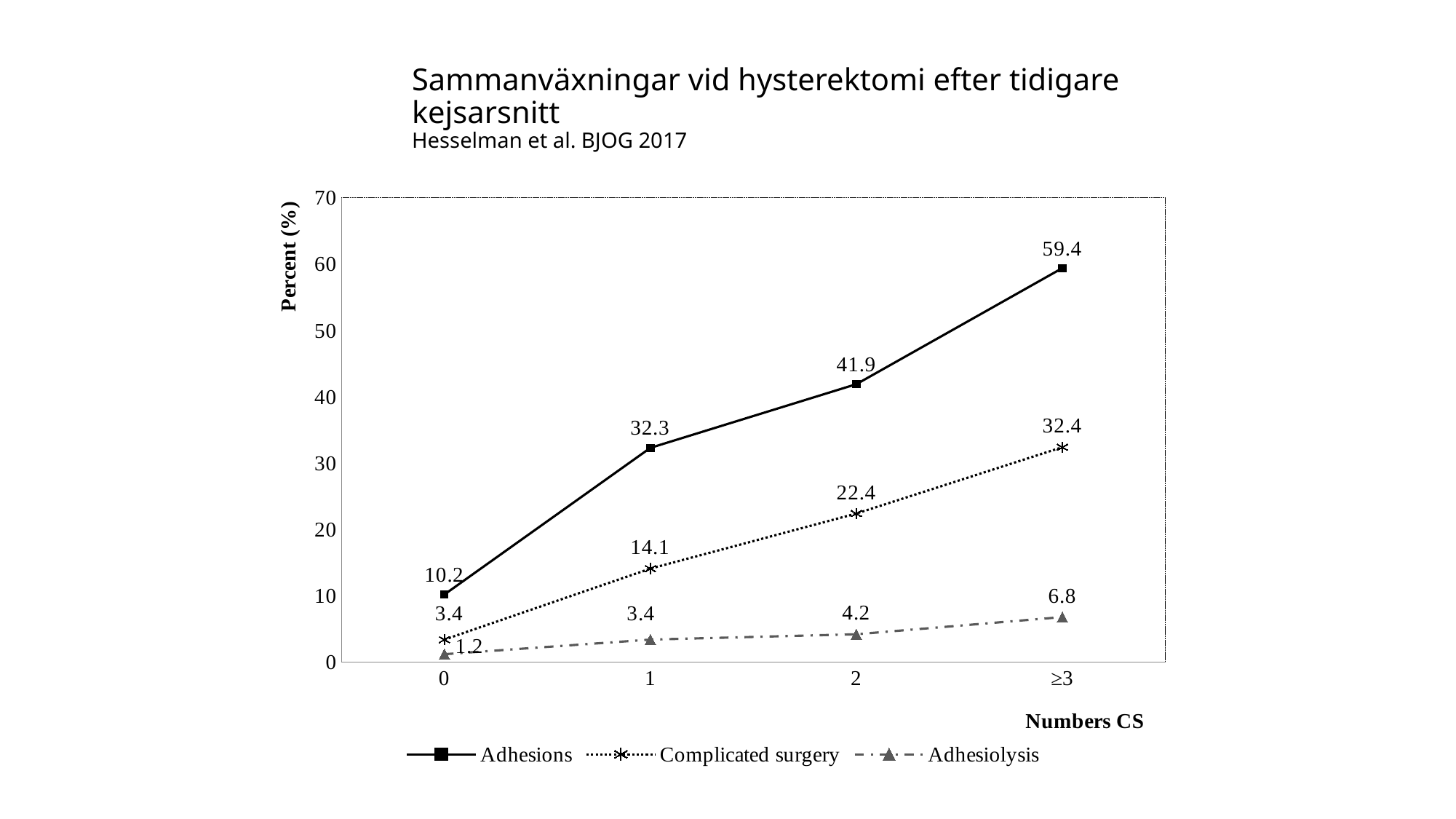
Which is larger at 2 previous CS: Adhesions or Complicated surgery? Adhesions What is the label of the y axis? Percent (%) At which number of CS is the Adhesiolysis value lowest? 0 How many series does the legend list? 3 What is the Adhesiolysis value at ≥3 previous CS? 6.8 What is the Adhesions value at 2 previous CS? 41.9 What is the difference between the Adhesions values at ≥3 and at 0 previous CS? 49.2 Do the Complicated surgery values rise or fall as the number of CS increases? Rise What kind of chart is shown on the slide? Line chart How many categories are shown on the x axis? 4 At which number of CS is the Adhesions value highest? ≥3 What is the Complicated surgery value at 1 previous CS? 14.1